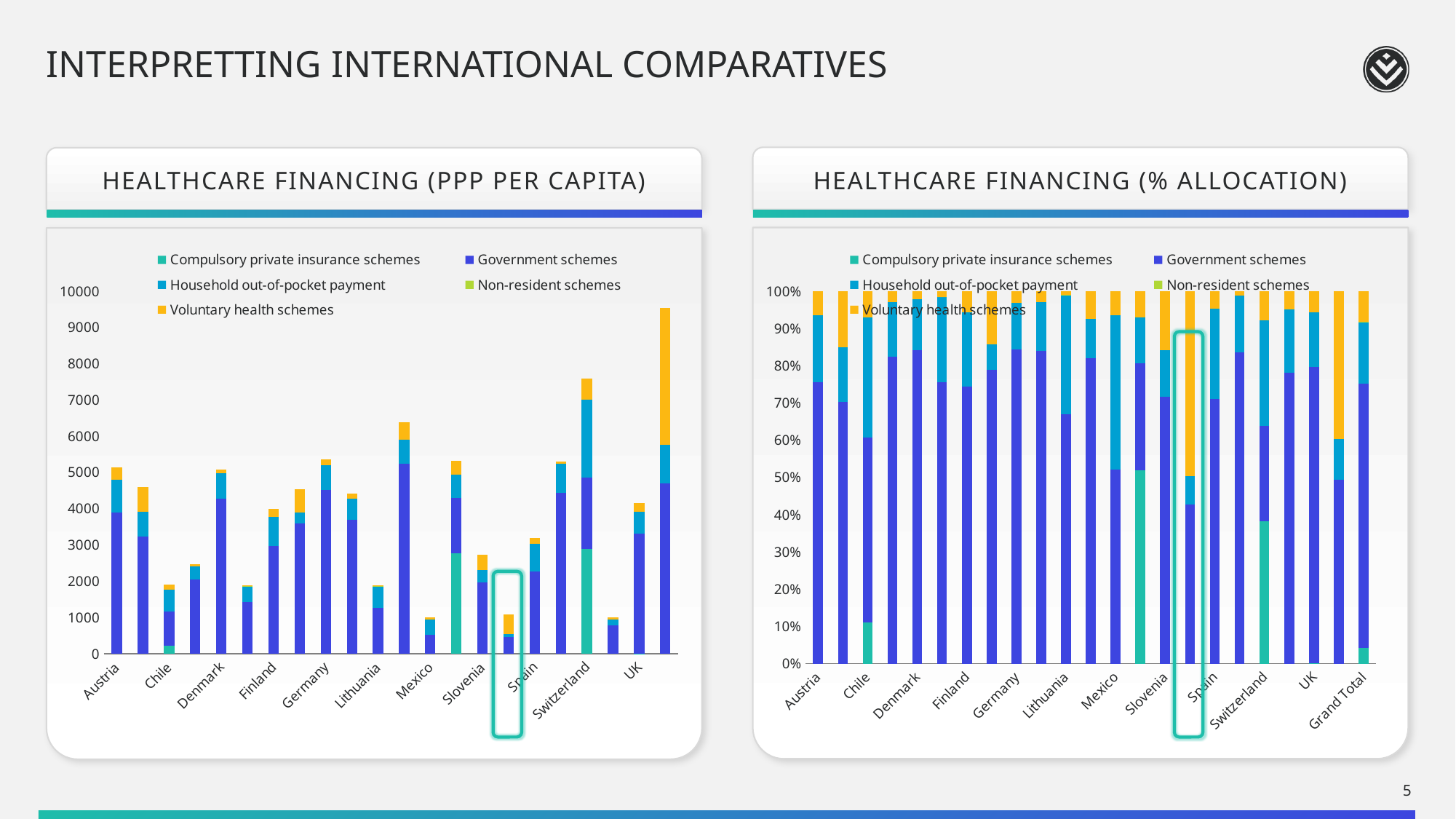
In the HEALTHCARE FINANCING (PPP PER CAPITA) chart, which has the larger total, Lithuania or Germany? Germany What kind of chart is the HEALTHCARE FINANCING (PPP PER CAPITA) chart? Stacked bar chart In the HEALTHCARE FINANCING (% ALLOCATION) chart, is the Government schemes share for Chile greater or less than 70%? less In the HEALTHCARE FINANCING (PPP PER CAPITA) chart, is the total for Mexico greater or less than 6000? less In the HEALTHCARE FINANCING (PPP PER CAPITA) chart, is the total for Switzerland greater or less than 7000? greater What is the title of the chart on the right side of the slide? HEALTHCARE FINANCING (% ALLOCATION) In the HEALTHCARE FINANCING (PPP PER CAPITA) chart, which colour represents Voluntary health schemes in the legend? Yellow In the HEALTHCARE FINANCING (PPP PER CAPITA) chart, which has the larger total, Switzerland or UK? Switzerland How many series does the legend of the HEALTHCARE FINANCING (% ALLOCATION) chart list? 5